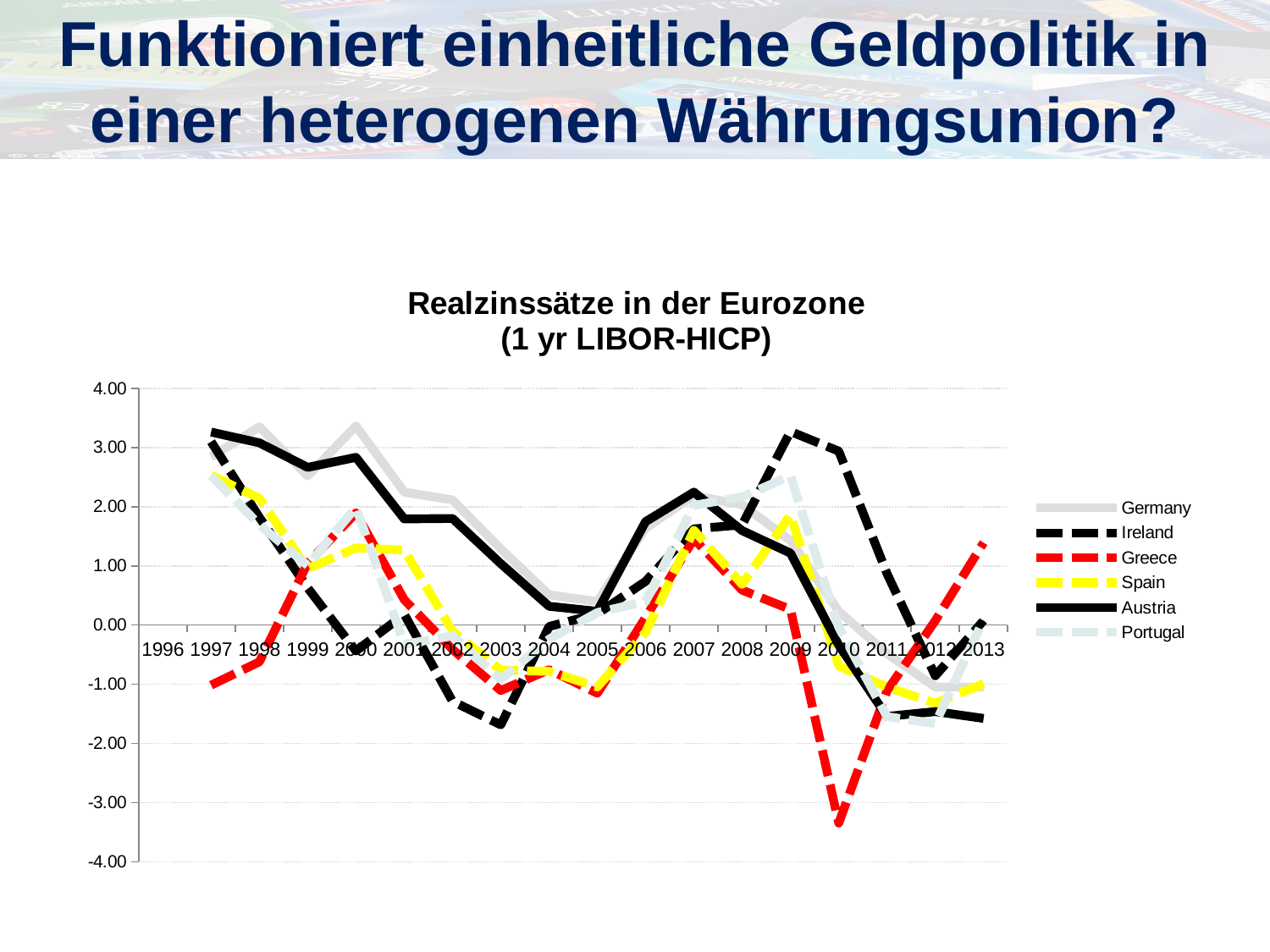
Which series reaches the lowest value anywhere on the chart? Greece How many year labels are shown on the x axis? 18 Does the value for Austria rise or fall from 1997 to 2004? fall In 2010, which is larger, the value for Ireland or the value for Greece? Ireland What is the title of the chart? Realzinssätze in der Eurozone (1 yr LIBOR-HICP) Is the value for Ireland in 2003 greater or less than -1.00? less In which year does Greece reach its lowest value? 2010 Which series is drawn as a red dashed line? Greece What kind of chart is shown on the slide? line chart Is the value for Greece in 2010 greater or less than -3.00? less How many series does the legend list? 6 Is the value for Ireland in 2009 greater or less than 2.00? greater